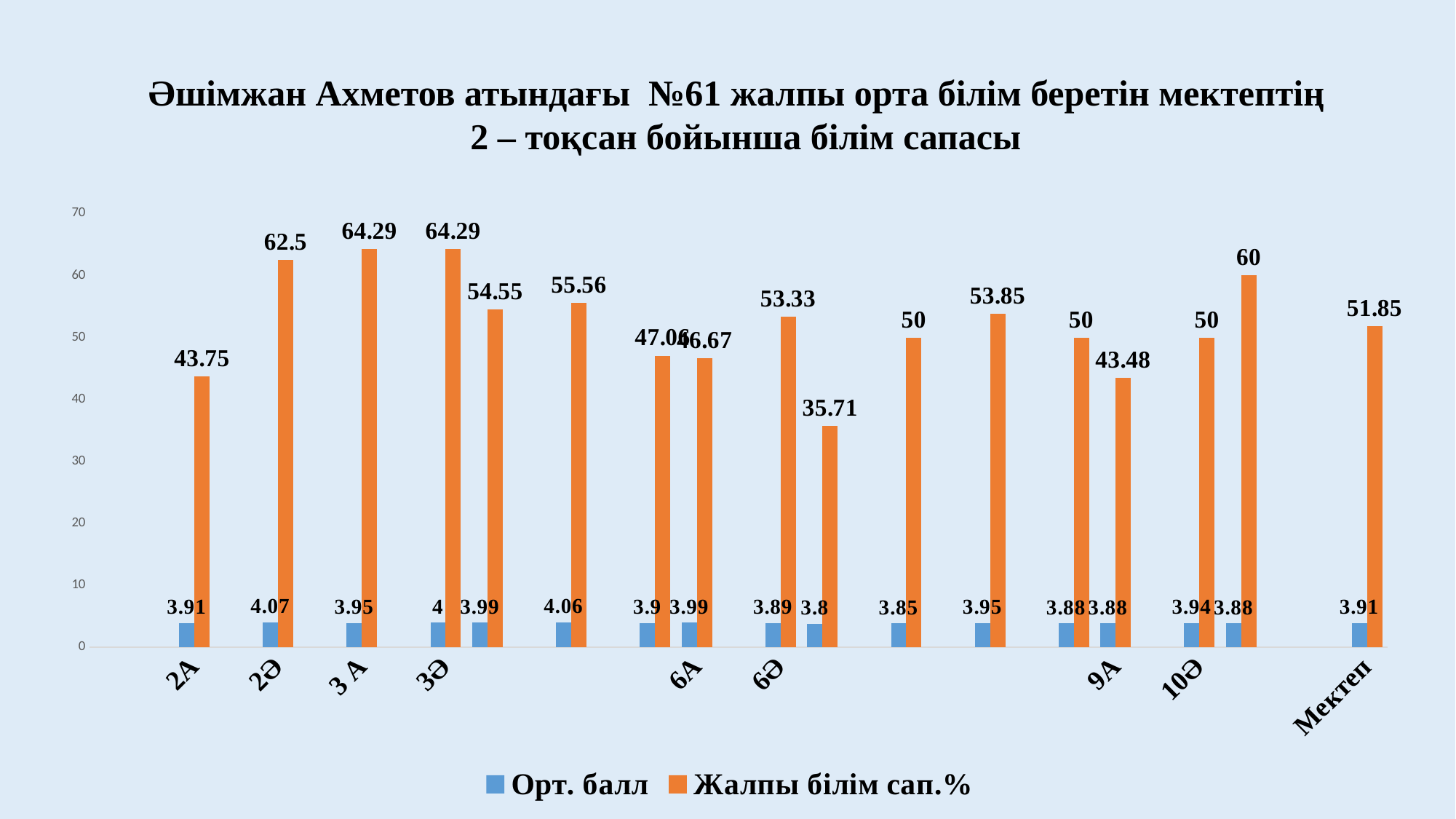
Which category has the highest Орт. балл value? 2Ә Which has the higher Жалпы білім сап.% value, 3 А or 2Ә? 3 А What kind of chart is shown on the slide? bar chart What is the Орт. балл value for 3Ә? 4 What is the Жалпы білім сап.% value for 2А? 43.75 What is the Орт. балл value for 2Ә? 4.07 What is the difference between the Жалпы білім сап.% values for 2Ә and 2А? 18.75 What is the Жалпы білім сап.% value for 6Ә? 53.33 How many series does the legend list? 2 What is the Жалпы білім сап.% value for Мектеп? 51.85 What are the two series named in the legend? Орт. балл and Жалпы білім сап.% Is the Жалпы білім сап.% value for 2А greater or less than 50? less